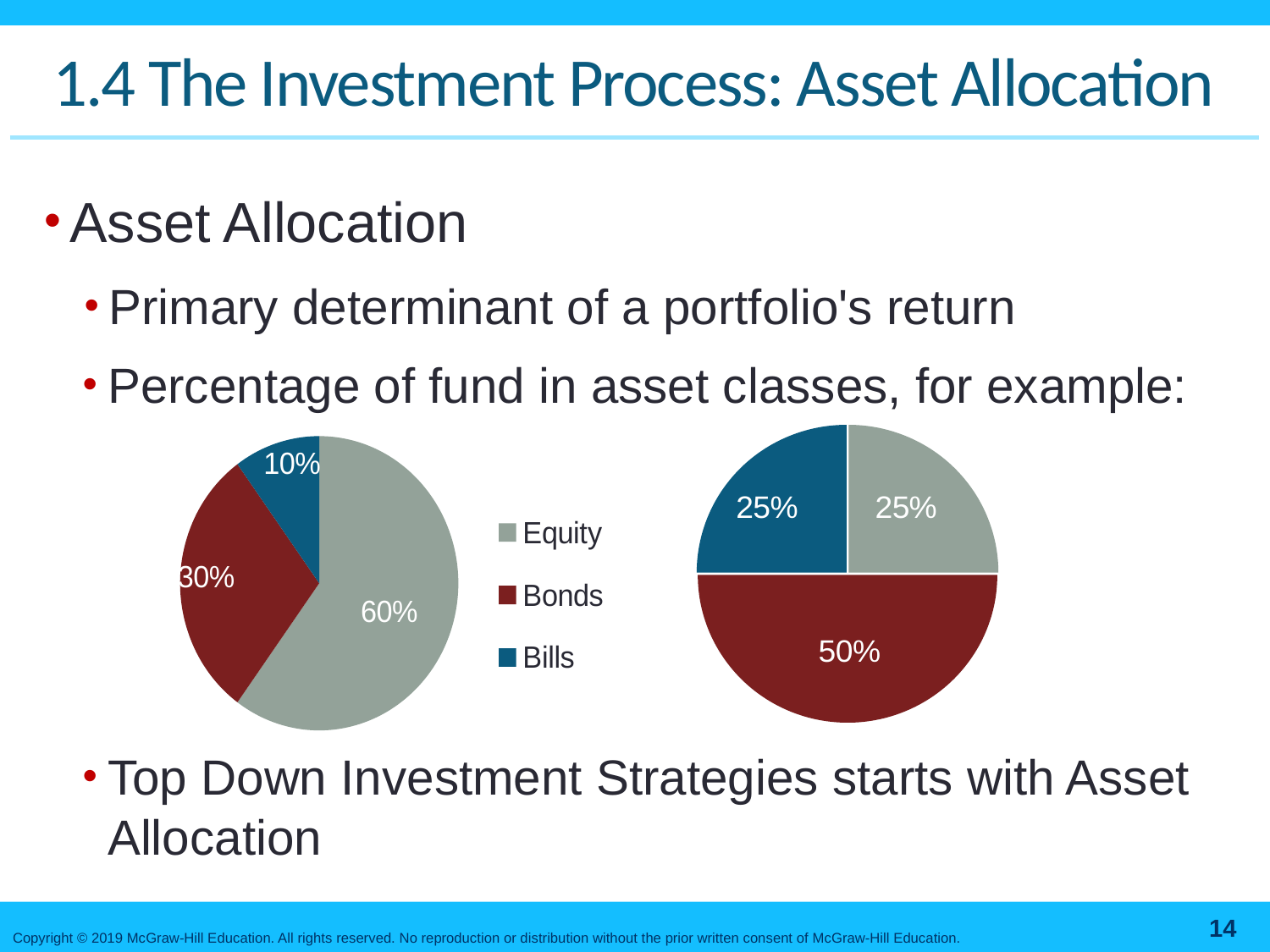
In the left pie chart, what is the difference between the Equity share and the Bonds share? 30% In the right pie chart, which is larger, the Bonds share or the Equity share? Bonds In the left pie chart, what percentage is allocated to Equity? 60% What type of chart is used on the left side of the slide? Pie chart In the left pie chart, what percentage is allocated to Bonds? 30% In the left pie chart, what percentage is allocated to Bills? 10% In the right pie chart, which asset class has the largest share? Bonds How many asset classes does the legend list? 3 In the left pie chart, which asset class has the largest share? Equity In the right pie chart, what percentage is allocated to Equity? 25% In the left pie chart, which asset class has the smallest share? Bills In the right pie chart, what percentage is allocated to Bonds? 50%